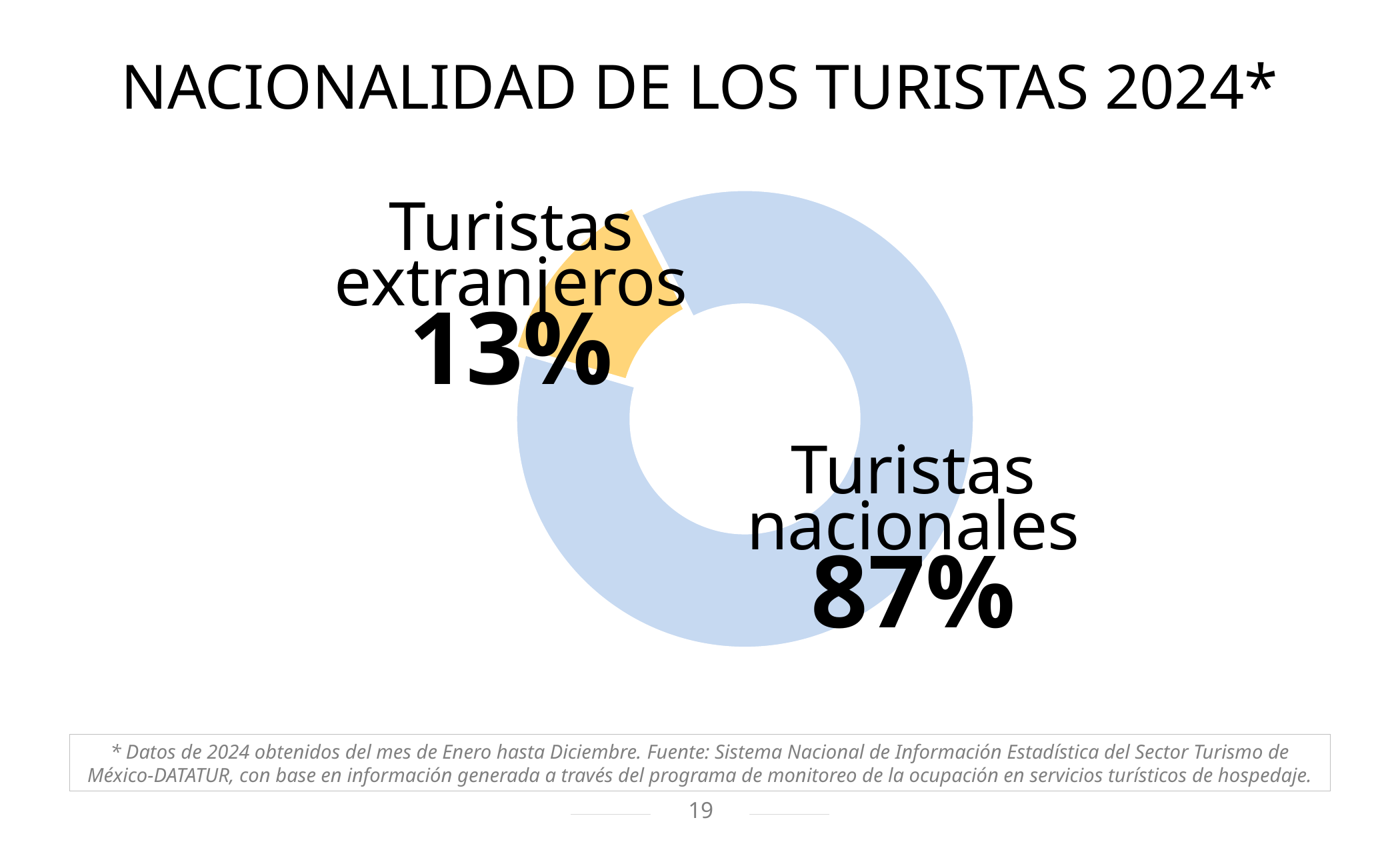
What percentage of tourists are Turistas nacionales? 87% What colour is the slice for Turistas extranjeros? Yellow What is the title of the slide? NACIONALIDAD DE LOS TURISTAS 2024* What is the combined share of Turistas nacionales and Turistas extranjeros? 100% What kind of chart is shown on the slide? Doughnut (pie) chart Which category has the smallest share of the chart? Turistas extranjeros What percentage of tourists are Turistas extranjeros? 13% How many categories does the chart show? 2 What is the difference in percentage points between Turistas nacionales and Turistas extranjeros? 74% Which category has the largest share of the chart? Turistas nacionales Which is larger, the share of Turistas extranjeros or Turistas nacionales? Turistas nacionales